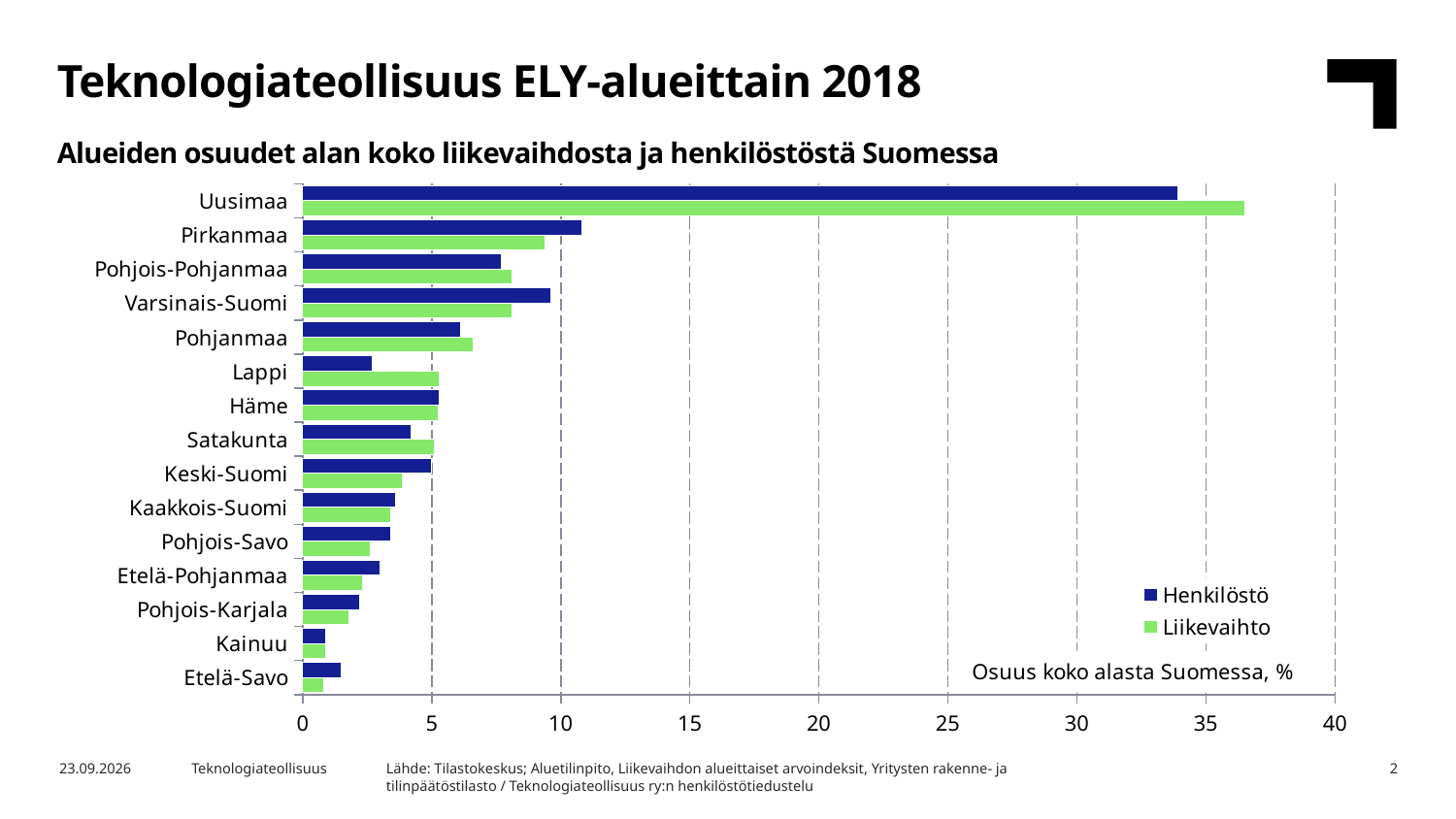
How many series does the legend list? 2 Is the Henkilöstö value for Lappi greater or less than 5? less Which region has the highest Liikevaihto share? Uusimaa How many regions are shown on the chart? 15 Is the Henkilöstö value for Uusimaa greater or less than 30? greater Which region has the lowest Henkilöstö share? Kainuu Is the Liikevaihto value for Pirkanmaa greater or less than 10? less Which region has the highest Henkilöstö share? Uusimaa For Lappi, which is larger: Henkilöstö or Liikevaihto? Liikevaihto What kind of chart is shown on the slide? bar chart Which series is shown in green in the legend? Liikevaihto